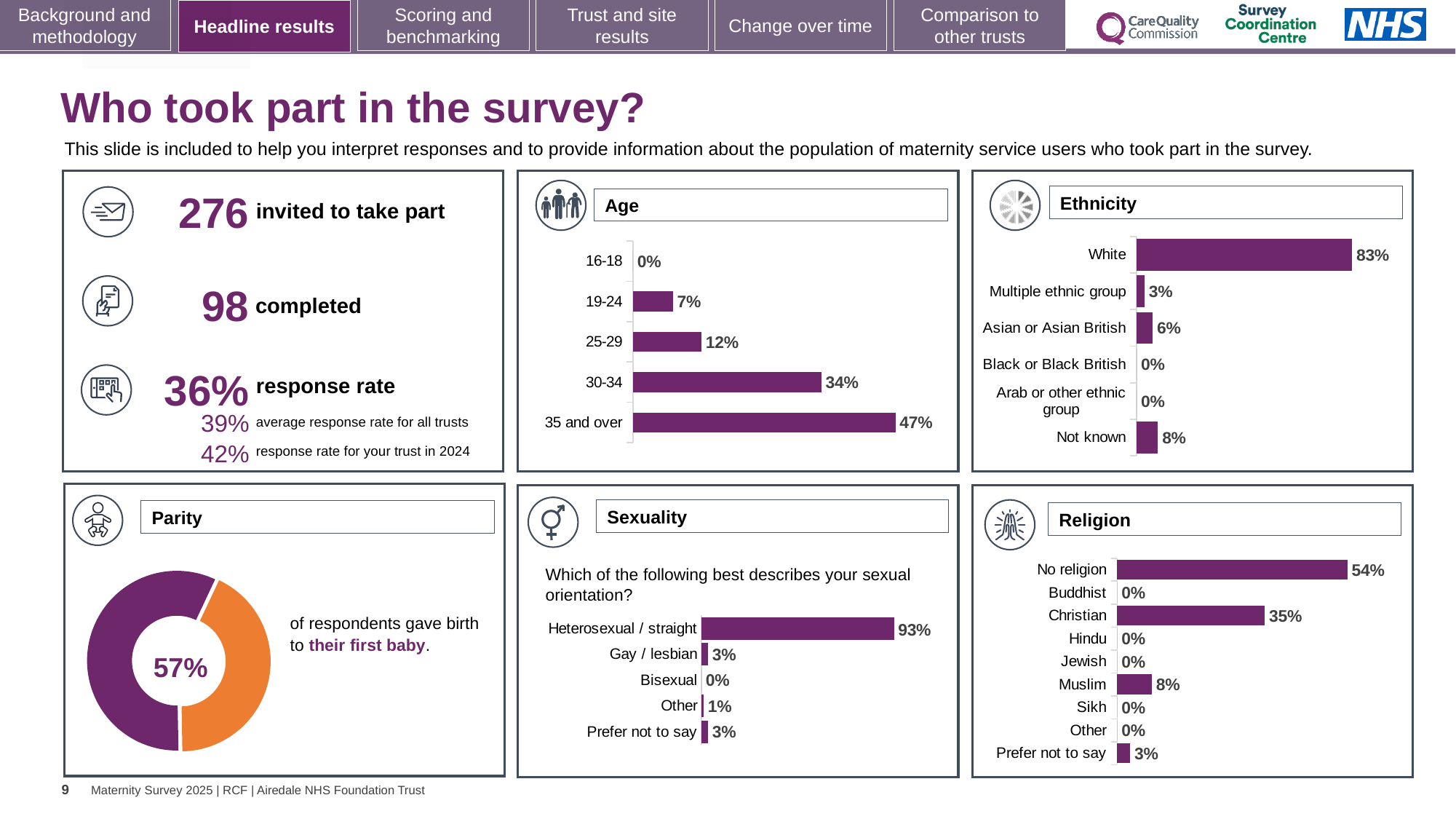
In the Parity chart, what share of respondents gave birth to their first baby? 57% In the Age chart, what percentage of respondents were aged 35 and over? 47% In the Religion chart, what is the difference between No religion and Christian? 19% In the Ethnicity chart, what percentage of respondents were White? 83% What kind of chart is the Sexuality chart? Bar chart In the Ethnicity chart, which is larger: Asian or Asian British or Multiple ethnic group? Asian or Asian British In the Sexuality chart, what percentage of respondents answered Heterosexual / straight? 93% In the Age chart, what is the difference between the 30-34 and 25-29 percentages? 22% In the Religion chart, what percentage of respondents were Christian? 35% In the Ethnicity chart, how many categories are shown? 6 In the Religion chart, which category has the highest percentage? No religion In the Age chart, which age group has the highest percentage? 35 and over